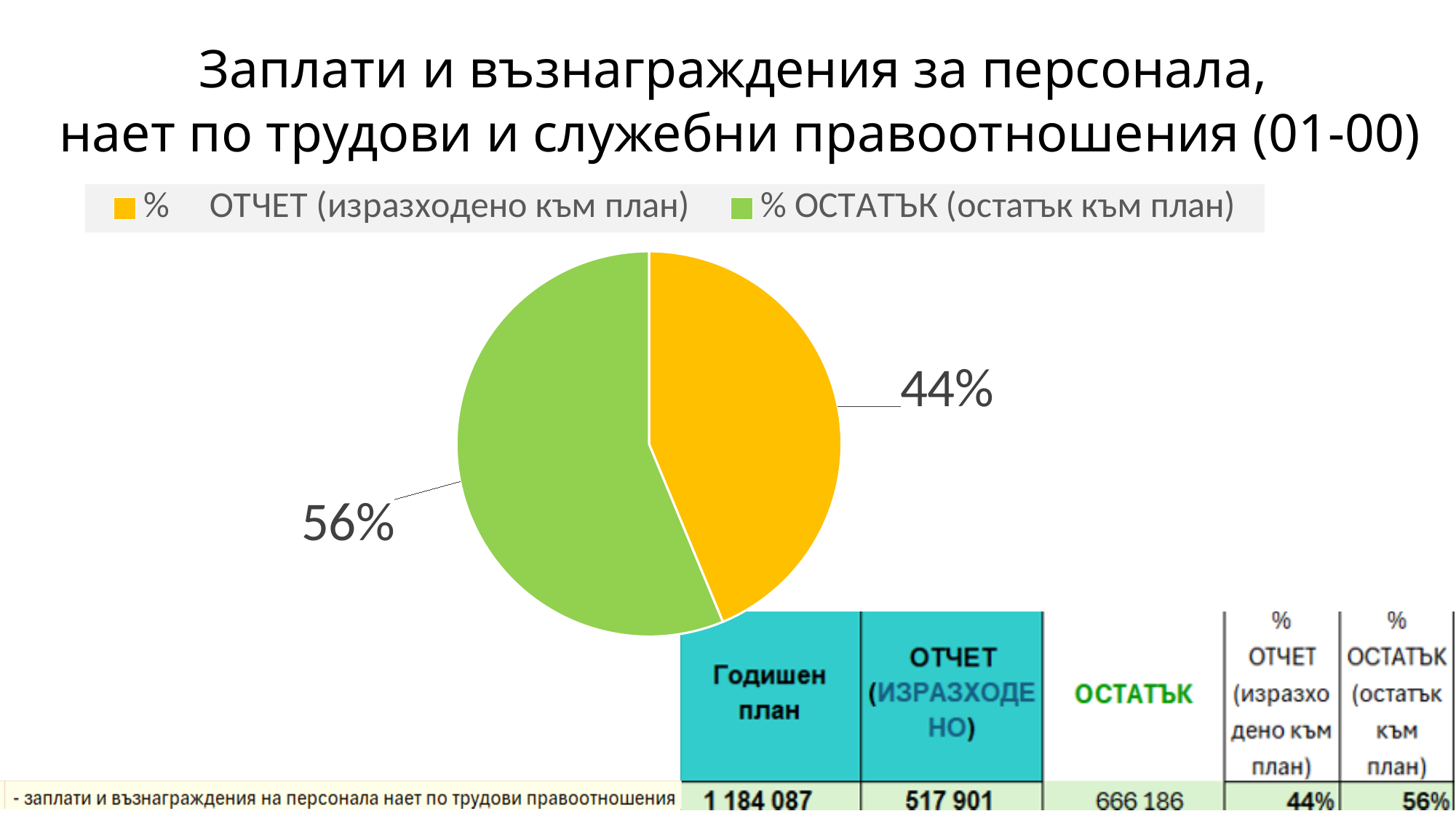
How many slices does the pie chart have? 2 How many entries does the legend list? 2 Which slice of the pie is the largest? % ОСТАТЪК (остатък към план) What colour is the "% ОСТАТЪК (остатък към план)" slice? green What share of the pie does the "% ОСТАТЪК (остатък към план)" slice represent? 56% Which slice of the pie is the smallest? % ОТЧЕТ (изразходено към план) What is the difference in percentage points between the "% ОСТАТЪК" slice and the "% ОТЧЕТ" slice? 12 What share of the pie does the "% ОТЧЕТ (изразходено към план)" slice represent? 44% What kind of chart is shown on the slide? pie chart Which is larger: the "% ОТЧЕТ" slice or the "% ОСТАТЪК" slice? % ОСТАТЪК What colour is the "% ОТЧЕТ (изразходено към план)" slice? orange